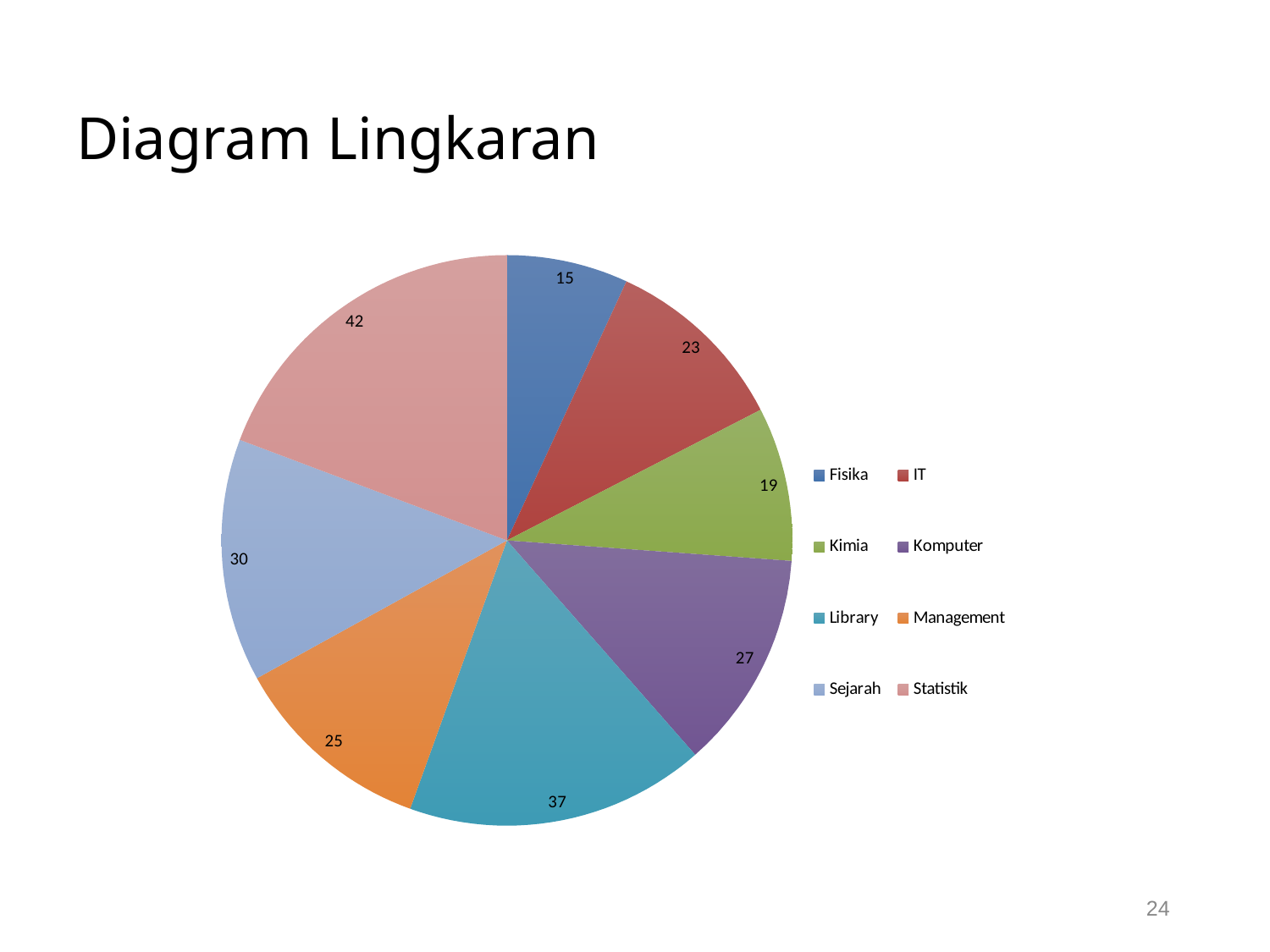
Which category has the largest slice in the pie chart? Statistik How many categories are shown in the pie chart? 8 What is the difference between the Statistik and Komputer values in the pie chart? 15 Which category is shown in orange in the pie chart? Management Which category has the smallest slice in the pie chart? Fisika What is the difference between the Library and Management values in the pie chart? 12 What is the value of the Fisika slice in the pie chart? 15 What is the title of the slide containing the pie chart? Diagram Lingkaran What is the value of the Sejarah slice in the pie chart? 30 What is the value of the Library slice in the pie chart? 37 What type of chart is shown on the slide? Pie chart Which is larger in the pie chart, IT or Kimia? IT